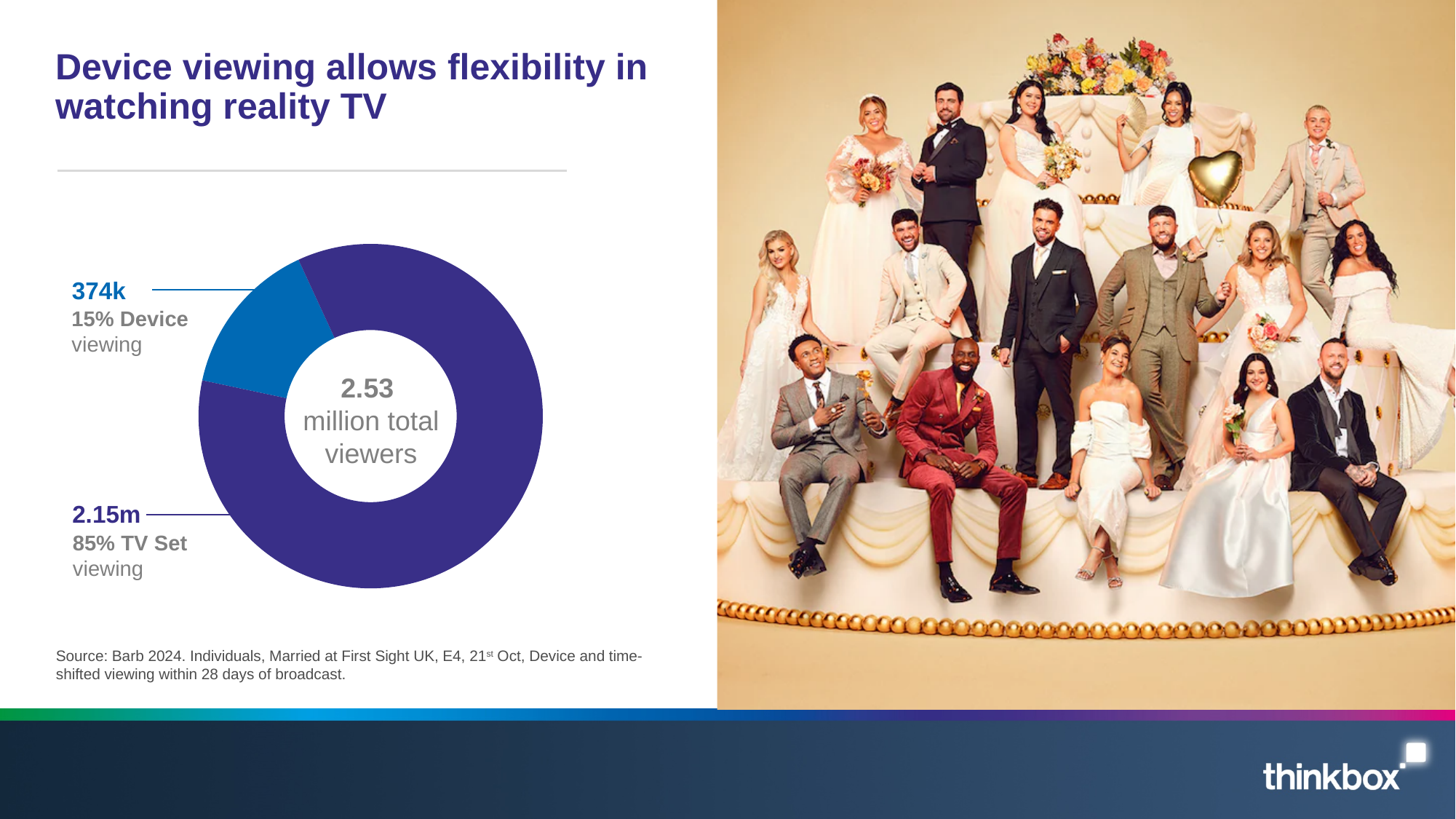
What is the difference in percentage points between TV Set viewing and Device viewing? 70 percentage points How many viewers does the chart show for Device viewing? 374k How many viewers does the chart show for TV Set viewing? 2.15m What share of viewing is TV Set viewing? 85% What share of viewing is Device viewing? 15% What kind of chart is shown on the slide? Doughnut (pie) chart Which segment is larger, Device viewing or TV Set viewing? TV Set viewing How many segments does the chart have? 2 What colour is the Device viewing segment? Blue Which segment has the smallest share of viewers? Device viewing What is the title of the slide containing the chart? Device viewing allows flexibility in watching reality TV What is the total number of viewers shown in the centre of the chart? 2.53 million